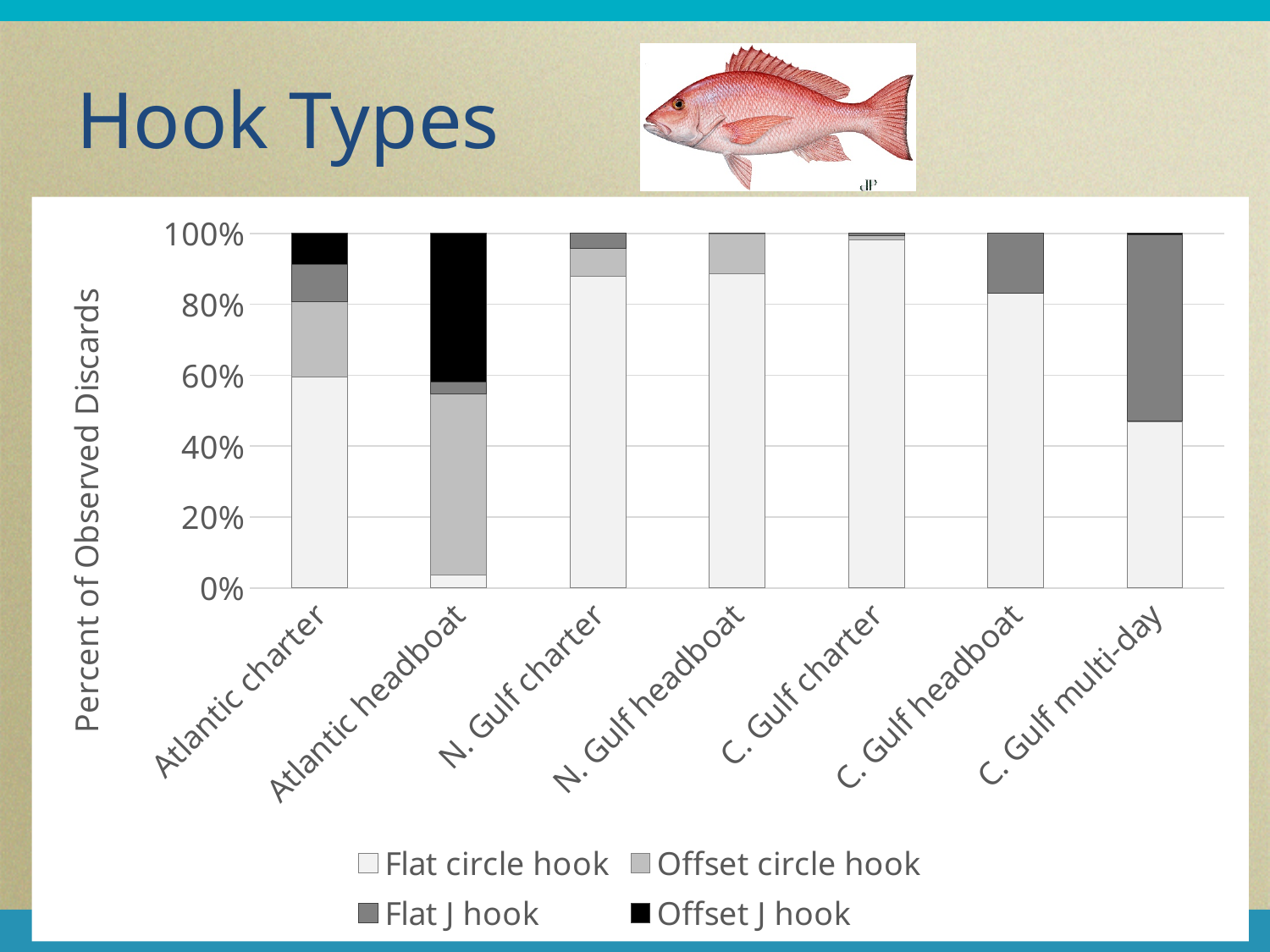
Which category has the largest Offset J hook share? Atlantic headboat What is the title of the slide containing the chart? Hook Types Is the Flat circle hook share for C. Gulf multi-day greater or less than 60%? less Which has a larger Flat circle hook share, N. Gulf charter or Atlantic headboat? N. Gulf charter Is the Flat circle hook share for Atlantic headboat greater or less than 20%? less What kind of chart is shown on the slide? Stacked bar chart Which category has the smallest Flat circle hook share? Atlantic headboat How many series does the chart's legend list? 4 Which category has the largest Flat J hook share? C. Gulf multi-day How many categories are shown along the x axis of the chart? 7 Is the Flat circle hook share for C. Gulf charter greater or less than 80%? greater What is the label on the vertical axis of the chart? Percent of Observed Discards